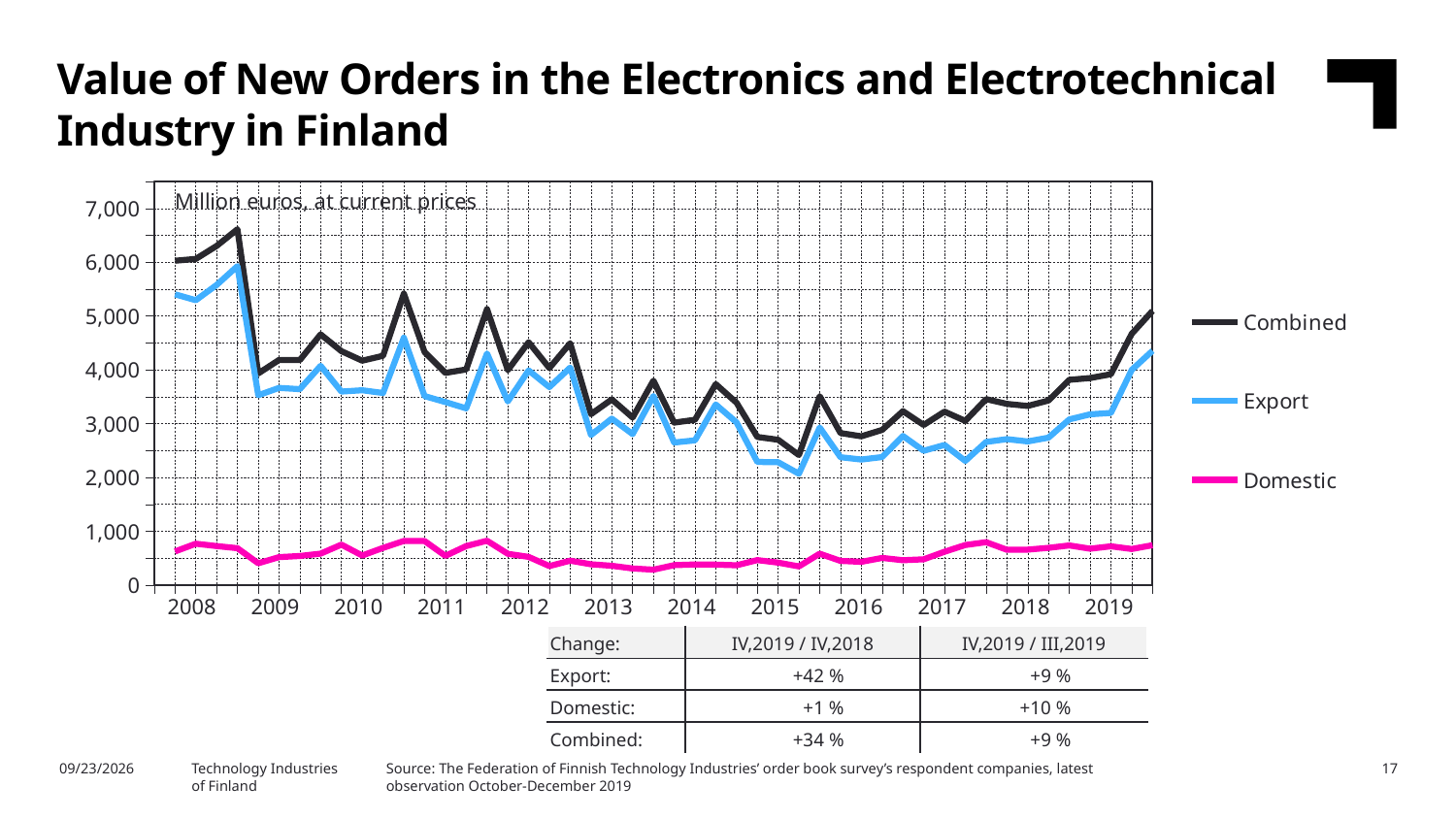
Is the peak value for Combined in 2008 greater or less than 6,000? greater Which series has the lowest values throughout the chart? Domestic Which series are listed in the legend? Combined, Export, Domestic Is the lowest value for Export in 2015 greater or less than 3,000? less Do the Combined values generally rise or fall from 2008 to 2015? fall How many series does the legend list? 3 Which series has the highest values throughout the chart? Combined Is the value for Domestic at any point greater or less than 1,000? less How many years are labelled on the x axis? 12 According to the table, what is the Export change for IV,2019 / IV,2018? +42 % What unit is stated for the values in the chart? Million euros, at current prices What kind of chart is shown on the slide? Line chart